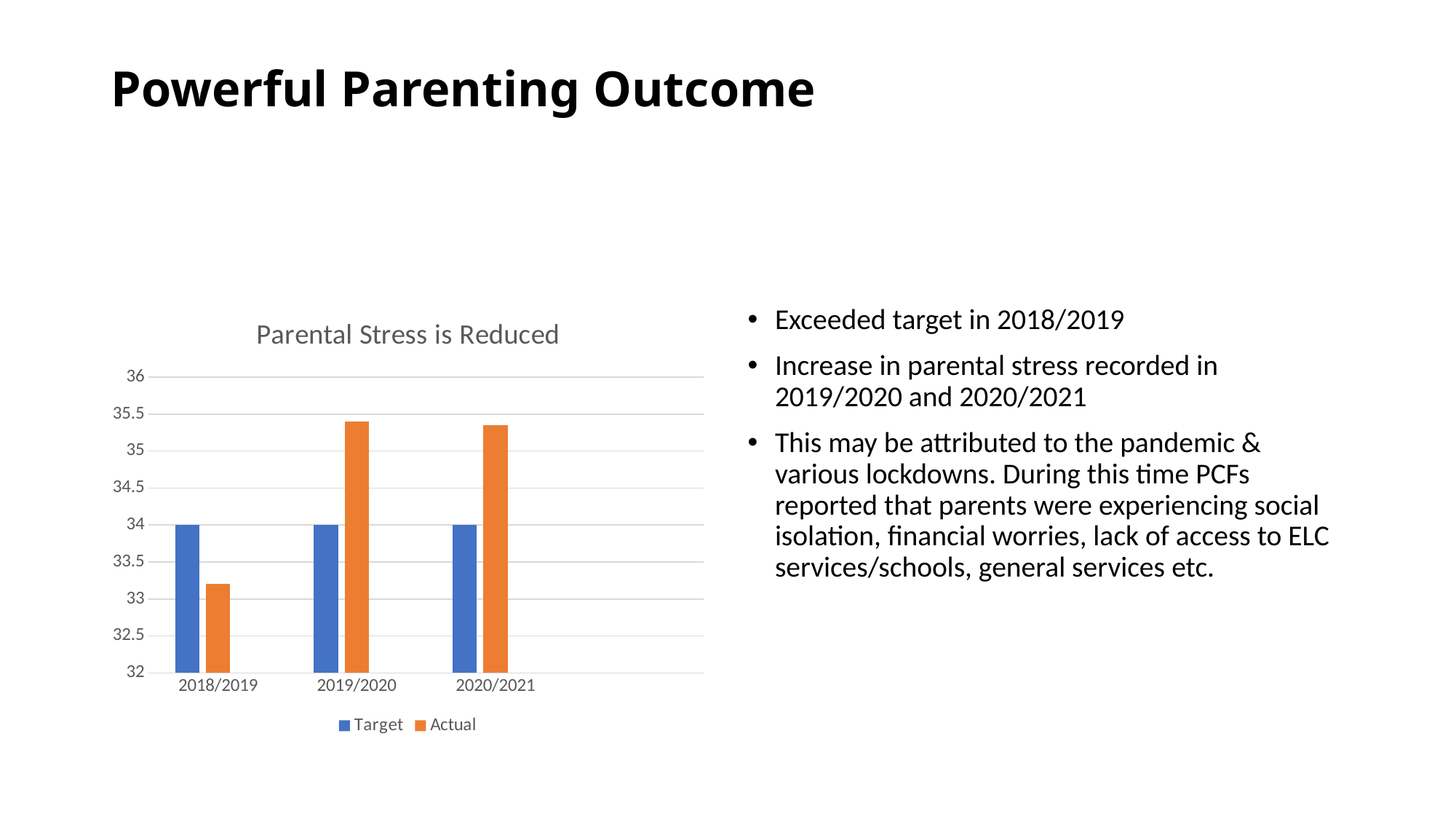
In 2018/2019, which is larger, the Target or the Actual value? Target What is the title of the chart? Parental Stress is Reduced What is the Target value for 2018/2019? 34 What is the Target value for 2020/2021? 34 Is the Actual value for 2019/2020 greater or less than 35? greater How many series does the chart legend list? 2 How many categories are shown on the x axis of the chart? 3 Which year has the lowest Actual value? 2018/2019 Which colour represents the Actual series in the chart? orange In 2019/2020, which is larger, the Target or the Actual value? Actual What type of chart is shown on the slide? bar chart Is the Actual value for 2018/2019 greater or less than 33.5? less